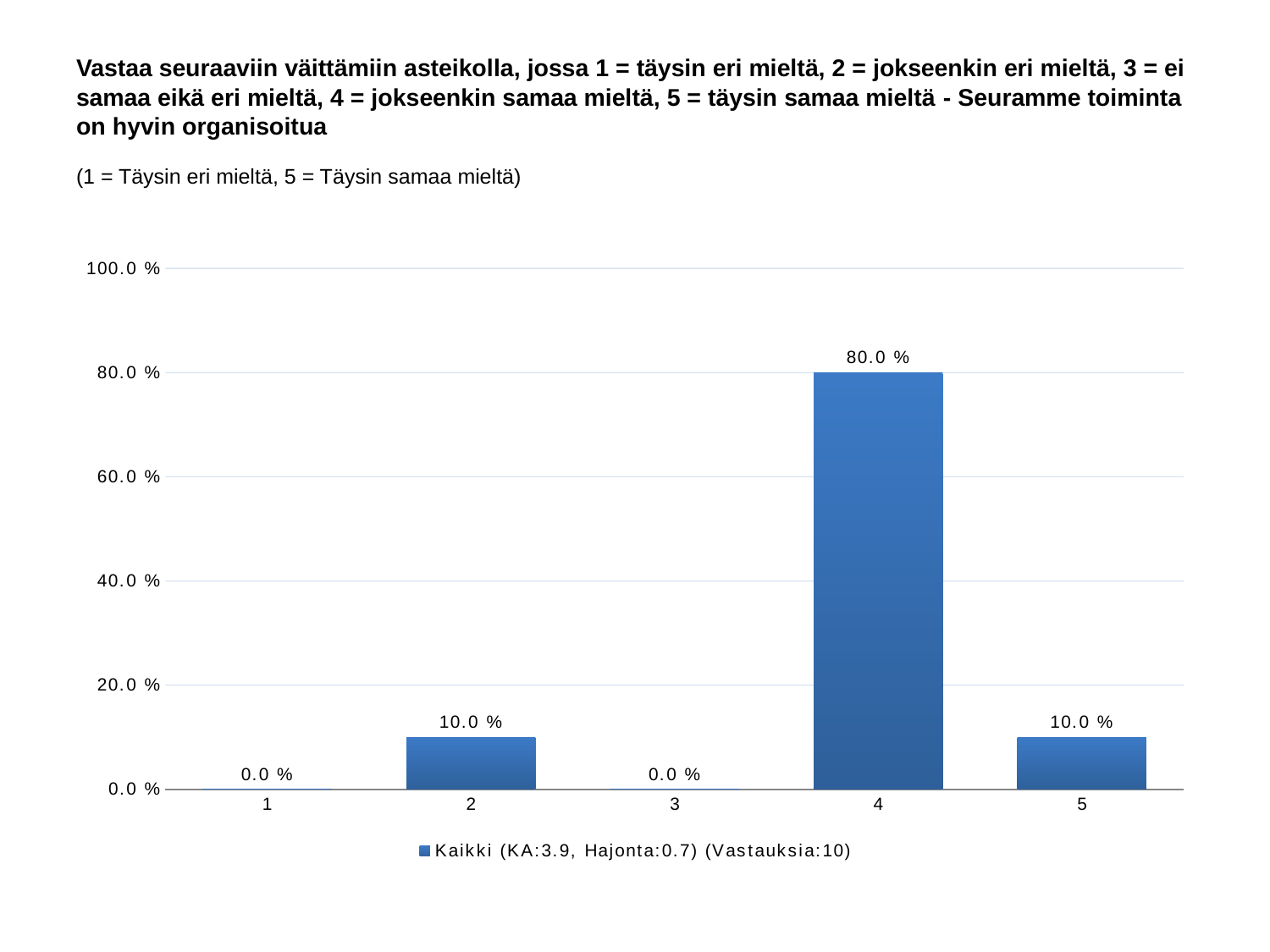
What kind of chart is shown on the slide? bar chart Which is larger, the value for category 2 or the value for category 4? 4 What is the value for category 4? 80.0 % What is the value for category 1? 0.0 % Which category has the highest value? 4 How many series does the legend list? 1 How many categories are shown on the x axis? 5 What is the value for category 5? 10.0 % What is the value for category 2? 10.0 % What is the difference between the values for category 4 and category 5? 70.0 % What is the legend entry for the series? Kaikki (KA:3.9, Hajonta:0.7) (Vastauksia:10) Is the value for category 4 greater or less than 60.0 %? greater